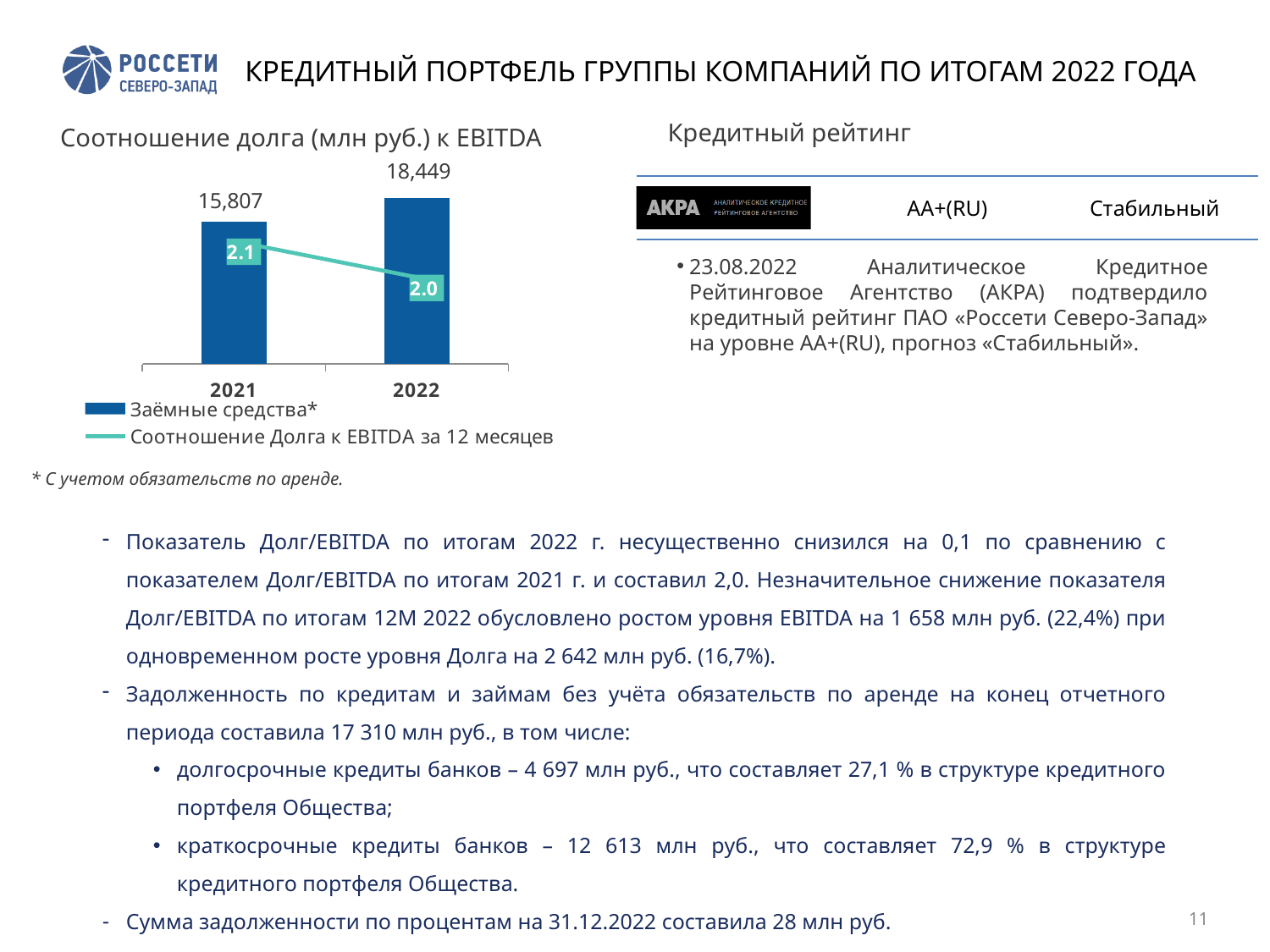
How many series does the chart legend list? 2 Which year has the lower Соотношение Долга к EBITDA за 12 месяцев value? 2022 What is the difference in Заёмные средства between 2022 and 2021? 2,642 Does the Соотношение Долга к EBITDA за 12 месяцев line rise or fall from 2021 to 2022? fall What is the Соотношение Долга к EBITDA за 12 месяцев value for 2021? 2.1 What is the value of Заёмные средства for 2021 in the chart? 15,807 By how much did the Соотношение Долга к EBITDA за 12 месяцев change from 2021 to 2022? 0.1 What is the value of Заёмные средства for 2022 in the chart? 18,449 What is the Соотношение Долга к EBITDA за 12 месяцев value for 2022? 2.0 How many years are shown on the x axis of the chart? 2 Which year has the higher value of Заёмные средства? 2022 Is the Заёмные средства value for 2021 larger or smaller than the value for 2022? smaller